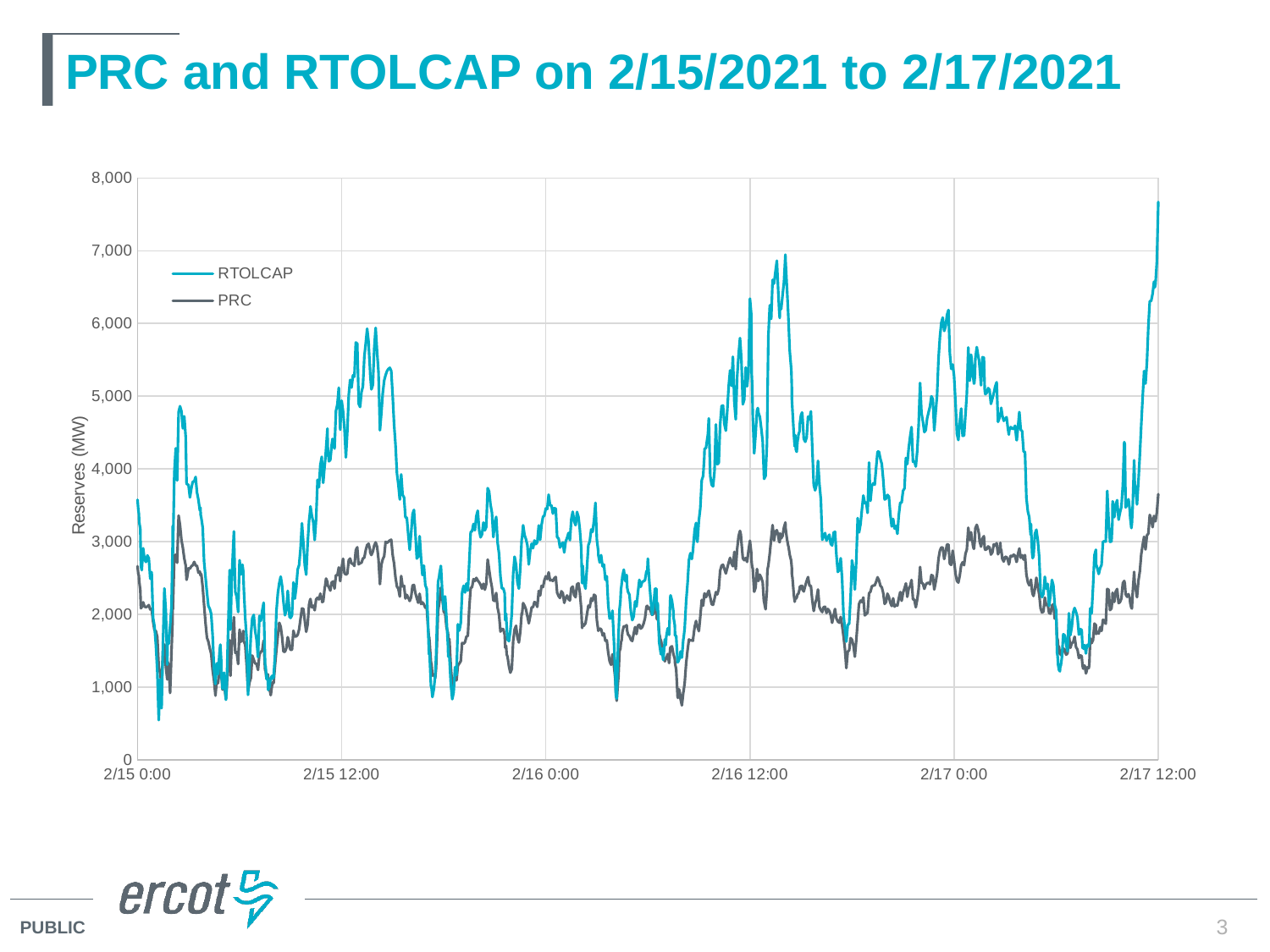
Is the value of RTOLCAP at 2/15 12:00 greater or less than 4,000? greater What is the label of the vertical axis? Reserves (MW) Is the value of PRC at the right end of the chart (2/17 12:00) greater or less than 3,000? greater Is the value of PRC at 2/16 0:00 greater or less than 3,000? less How many series does the legend list? 2 Which series is plotted higher throughout the chart, RTOLCAP or PRC? RTOLCAP What is the highest value shown on the vertical axis? 8,000 What is the title of the chart? PRC and RTOLCAP on 2/15/2021 to 2/17/2021 How many time labels are shown on the horizontal axis? 6 What kind of chart is shown on the slide? Line chart